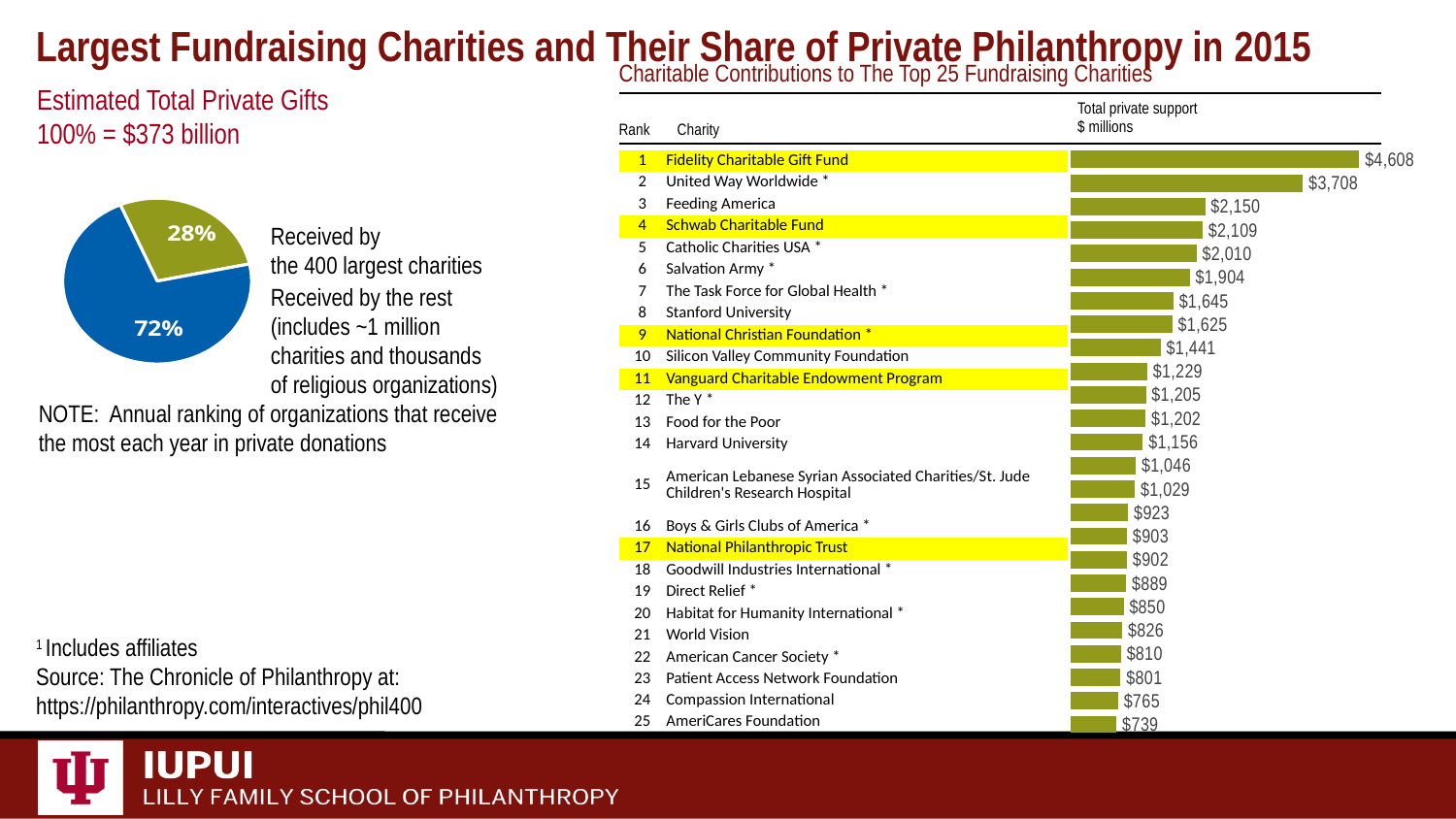
In the chart 'Charitable Contributions to The Top 25 Fundraising Charities', what is the difference in total private support between Fidelity Charitable Gift Fund and United Way Worldwide? $900 What kind of chart is 'Charitable Contributions to The Top 25 Fundraising Charities'? Bar chart In the chart 'Charitable Contributions to The Top 25 Fundraising Charities', which charity has the highest total private support? Fidelity Charitable Gift Fund In the chart 'Charitable Contributions to The Top 25 Fundraising Charities', do the bar values rise or fall as you go down the ranking from 1 to 25? Fall How many charities are shown in the chart 'Charitable Contributions to The Top 25 Fundraising Charities'? 25 In the chart 'Charitable Contributions to The Top 25 Fundraising Charities', which charity has the lowest total private support? AmeriCares Foundation In the pie chart 'Estimated Total Private Gifts', what share was received by the 400 largest charities? 28% In the chart 'Charitable Contributions to The Top 25 Fundraising Charities', what is the total private support for Feeding America? $2,150 In the pie chart 'Estimated Total Private Gifts', what share was received by the rest? 72% In the chart 'Charitable Contributions to The Top 25 Fundraising Charities', which has greater total private support, Stanford University or Harvard University? Stanford University In the chart 'Charitable Contributions to The Top 25 Fundraising Charities', what is the total private support for Fidelity Charitable Gift Fund? $4,608 What kind of chart is 'Estimated Total Private Gifts'? Pie chart